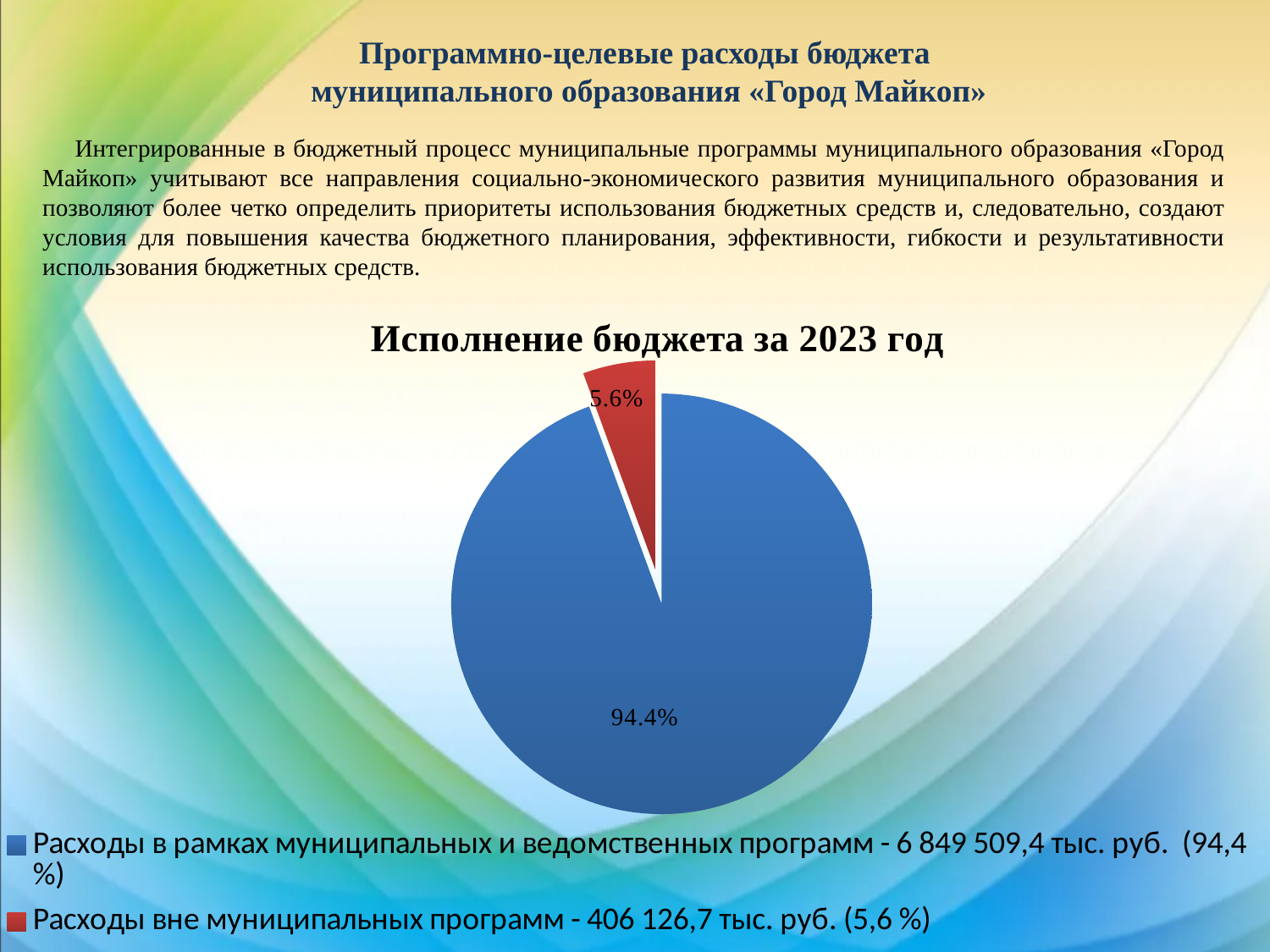
Which is larger: the share for Расходы в рамках муниципальных и ведомственных программ or the share for Расходы вне муниципальных программ? Расходы в рамках муниципальных и ведомственных программ What kind of chart is shown on the slide? pie chart What is the difference in percentage points between the 94.4% slice and the 5.6% slice? 88.8 What is the title of the chart? Исполнение бюджета за 2023 год What share of the pie is labelled for the blue slice (Расходы в рамках муниципальных и ведомственных программ)? 94.4% Which category has the smallest share of the pie? Расходы вне муниципальных программ How many entries does the legend list? 2 Which category has the largest share of the pie? Расходы в рамках муниципальных и ведомственных программ According to the legend, what is the amount for Расходы вне муниципальных программ? 406 126,7 тыс. руб. What share of the pie is labelled for the red slice (Расходы вне муниципальных программ)? 5.6% According to the legend, what is the amount for Расходы в рамках муниципальных и ведомственных программ? 6 849 509,4 тыс. руб. How many slices does the pie chart have? 2